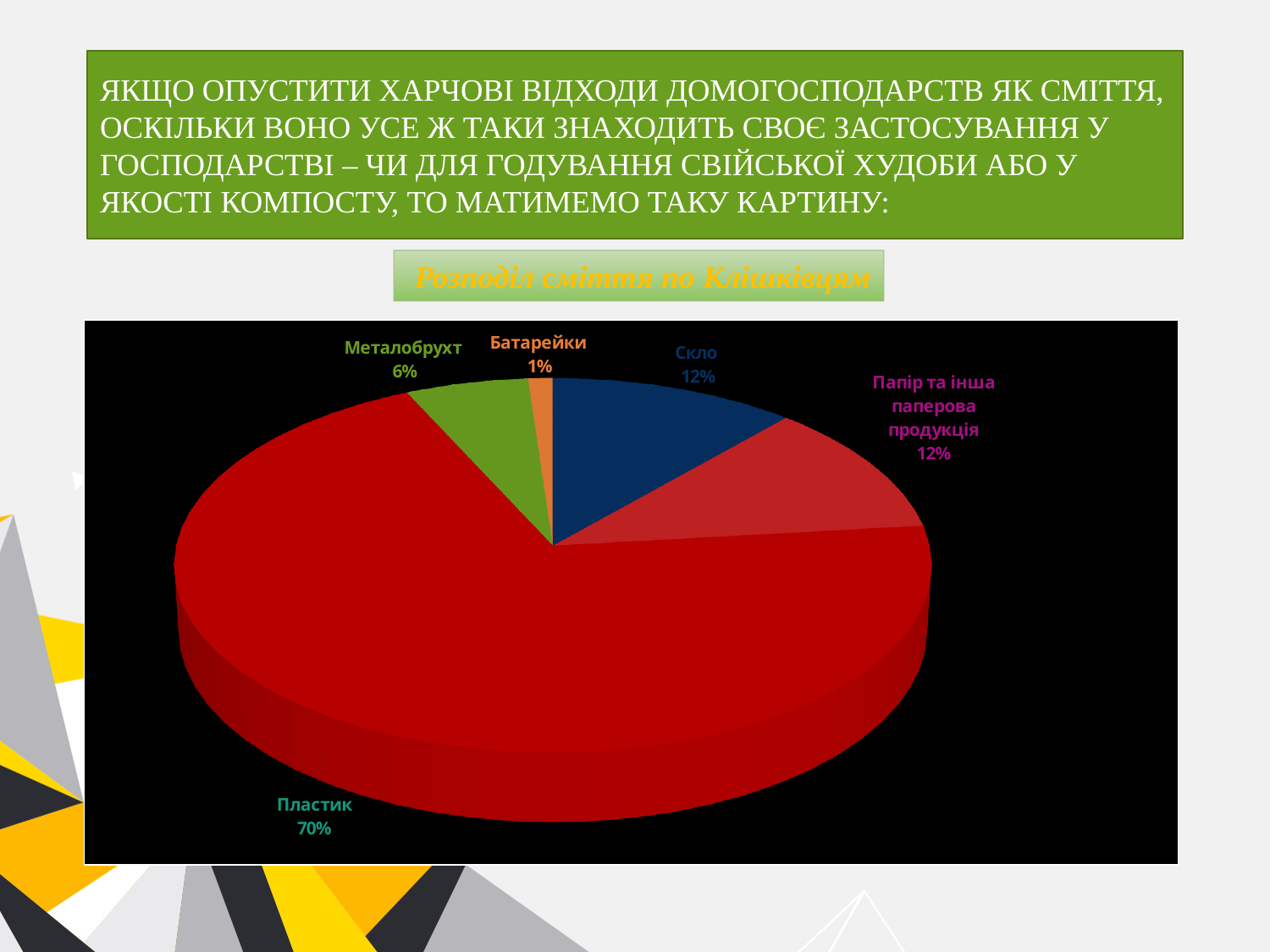
What is the difference in percentage points between Пластик and Скло? 58 What share of the pie does Пластик take? 70% What share of the pie does Папір та інша паперова продукція take? 12% What share of the pie does Металобрухт take? 6% What kind of chart is shown on the slide? pie chart Which category has the smallest slice of the pie? Батарейки What is the title of the chart? Розподіл сміття по Клішківцям Which category has the largest slice of the pie? Пластик Which is larger, the share for Металобрухт or the share for Скло? Скло How many categories are shown in the pie chart? 5